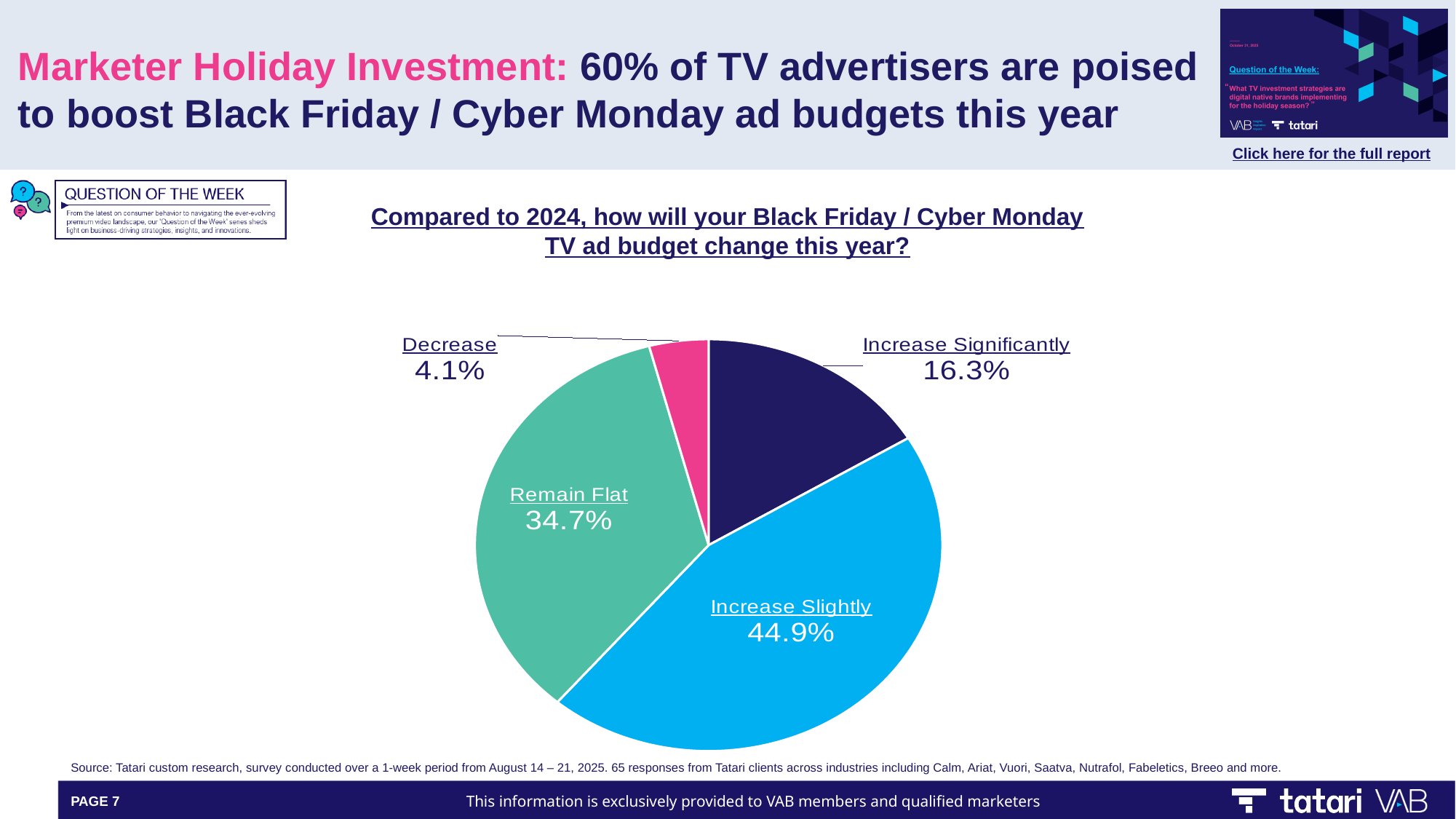
What share of respondents said their Black Friday / Cyber Monday TV ad budget will Increase Slightly? 44.9% What colour is the Remain Flat slice? Green Which response has the smallest slice of the pie? Decrease What is the difference in percentage points between Increase Slightly and Remain Flat? 10.2 What percentage of respondents said their budget will Increase Significantly? 16.3% Which response has the largest slice of the pie? Increase Slightly What percentage of respondents said their budget will Decrease? 4.1% What percentage of respondents said their budget will Remain Flat? 34.7% Which is larger: the share for Increase Significantly or the share for Decrease? Increase Significantly What kind of chart is shown on the slide? Pie chart What is the combined share of respondents who said Increase Slightly or Increase Significantly? 61.2% How many slices does the pie chart have? 4